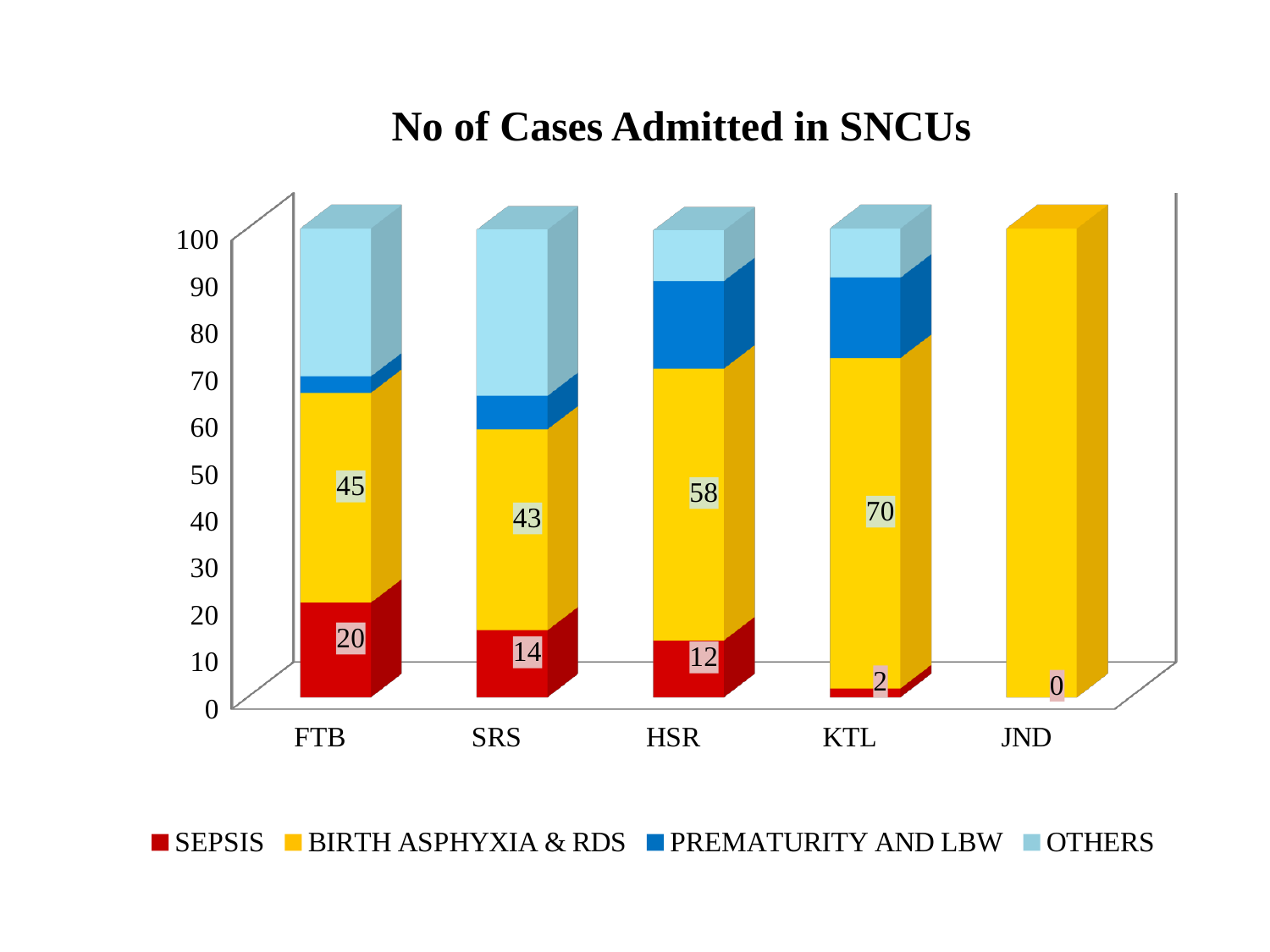
Which SNCU has the lowest SEPSIS value? JND What kind of chart is shown on the slide? Stacked bar chart What is the SEPSIS value for FTB? 20 How many SNCUs are shown on the x axis? 5 How many series does the legend list? 4 What is the BIRTH ASPHYXIA & RDS value for KTL? 70 What is the BIRTH ASPHYXIA & RDS value for SRS? 43 Which SNCU has the highest SEPSIS value? FTB What is the title of the chart? No of Cases Admitted in SNCUs What is the difference between the BIRTH ASPHYXIA & RDS values for HSR and FTB? 13 What is the SEPSIS value for HSR? 12 Which is larger, the SEPSIS value for SRS or for HSR? SRS